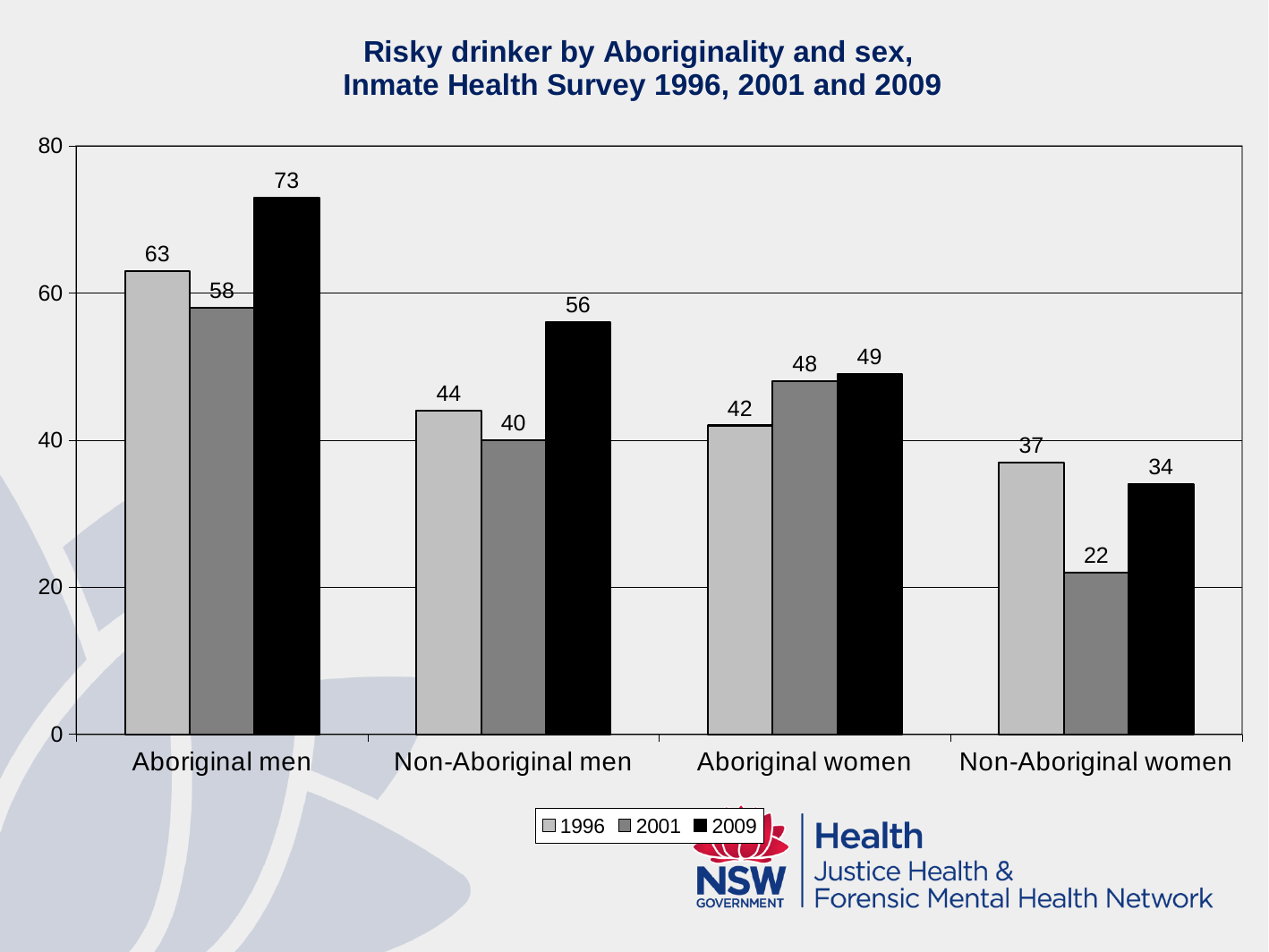
What is the value for Non-Aboriginal women in 2001? 22 How many categories are shown on the x axis? 4 Which is larger for Aboriginal men: the 1996 value or the 2001 value? 1996 What kind of chart is shown on the slide? Bar chart What is the value for Aboriginal men in 2009? 73 Which category has the highest value in the 2009 series? Aboriginal men What is the difference between the 2009 and 1996 values for Non-Aboriginal men? 12 How many series does the legend list? 3 What is the value for Aboriginal women in 1996? 42 Which category has the lowest value in the 2001 series? Non-Aboriginal women Which series is shown in black in the legend? 2009 Does the 1996 series rise or fall from Aboriginal men to Non-Aboriginal women? Fall